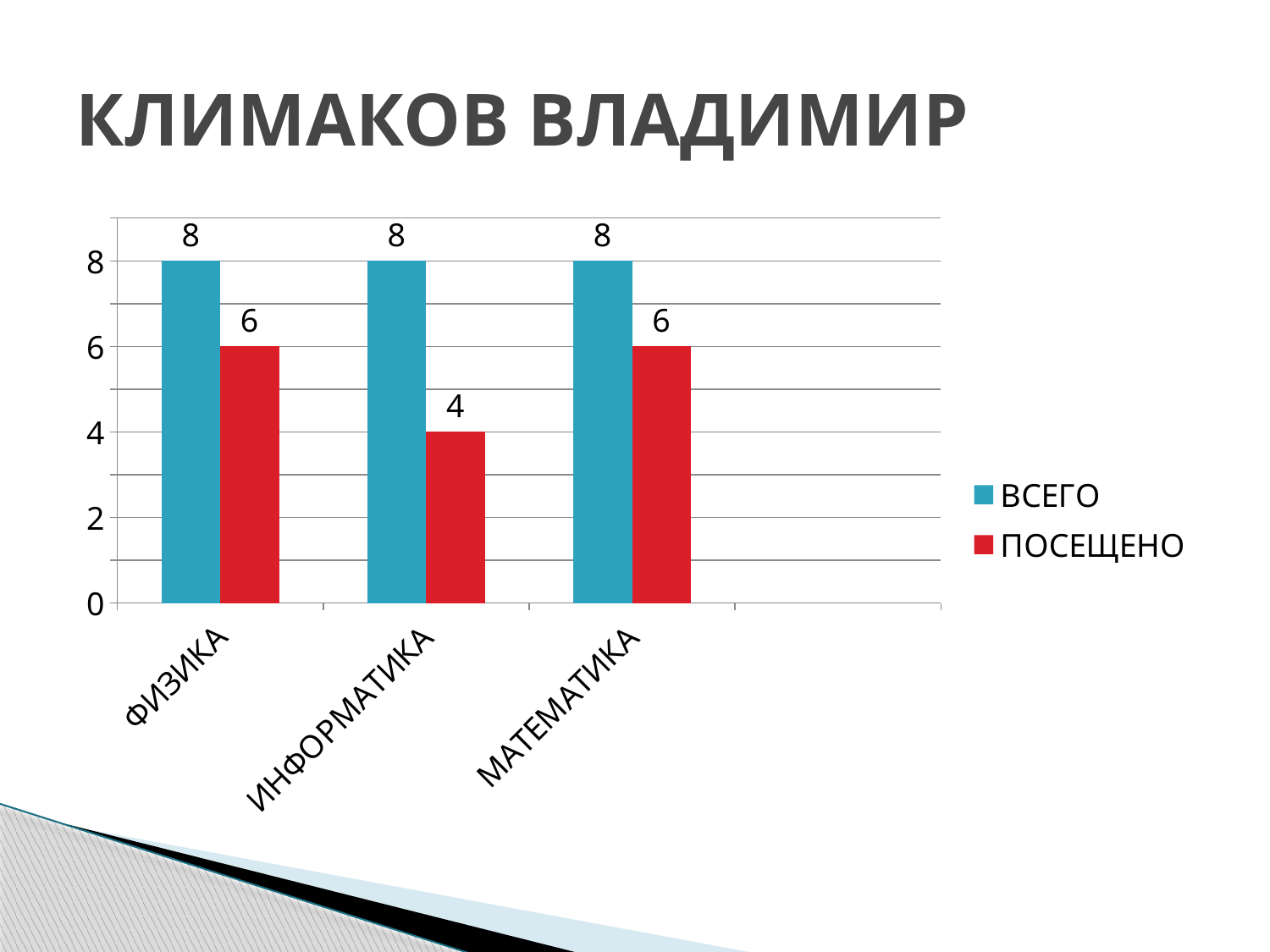
What is the difference between ВСЕГО and ПОСЕЩЕНО for ИНФОРМАТИКА? 4 Which is larger, the ПОСЕЩЕНО value for ФИЗИКА or for ИНФОРМАТИКА? ФИЗИКА What is the ВСЕГО value for ФИЗИКА? 8 Which colour represents the ПОСЕЩЕНО series? Red How many series does the legend list? 2 Which category has the lowest ПОСЕЩЕНО value? ИНФОРМАТИКА What is the ПОСЕЩЕНО value for ИНФОРМАТИКА? 4 What is the title of the slide? КЛИМАКОВ ВЛАДИМИР What is the ПОСЕЩЕНО value for МАТЕМАТИКА? 6 How many categories are shown on the x axis? 3 What is the difference between ВСЕГО and ПОСЕЩЕНО for ФИЗИКА? 2 What kind of chart is shown on the slide? Bar chart